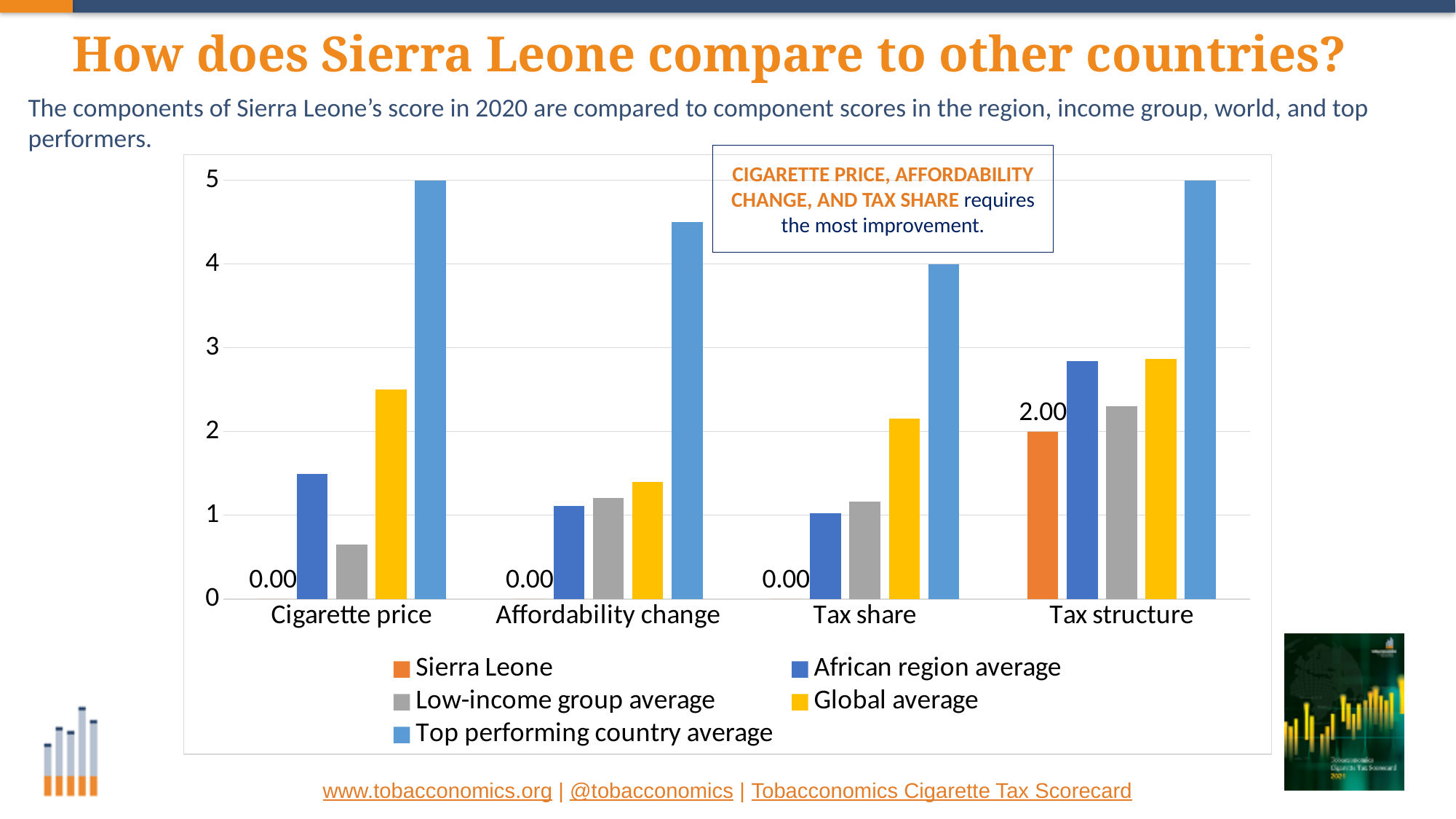
Which series has the highest value in the Tax share category? Top performing country average In which category does Sierra Leone have its highest value? Tax structure How many categories are shown on the x axis? 4 What is the value for Top performing country average in the Tax share category? 4 Is the value for Global average in the Cigarette price category greater or less than 2? greater How many series does the legend list? 5 In the Cigarette price category, which is larger: Global average or African region average? Global average What is the difference between the Top performing country average values for Cigarette price and Tax share? 1 Is the value for African region average in the Tax share category greater or less than 2? less What is the value for Top performing country average in the Cigarette price category? 5 What is the value for Sierra Leone in the Tax structure category? 2.00 What is the value for Sierra Leone in the Cigarette price category? 0.00